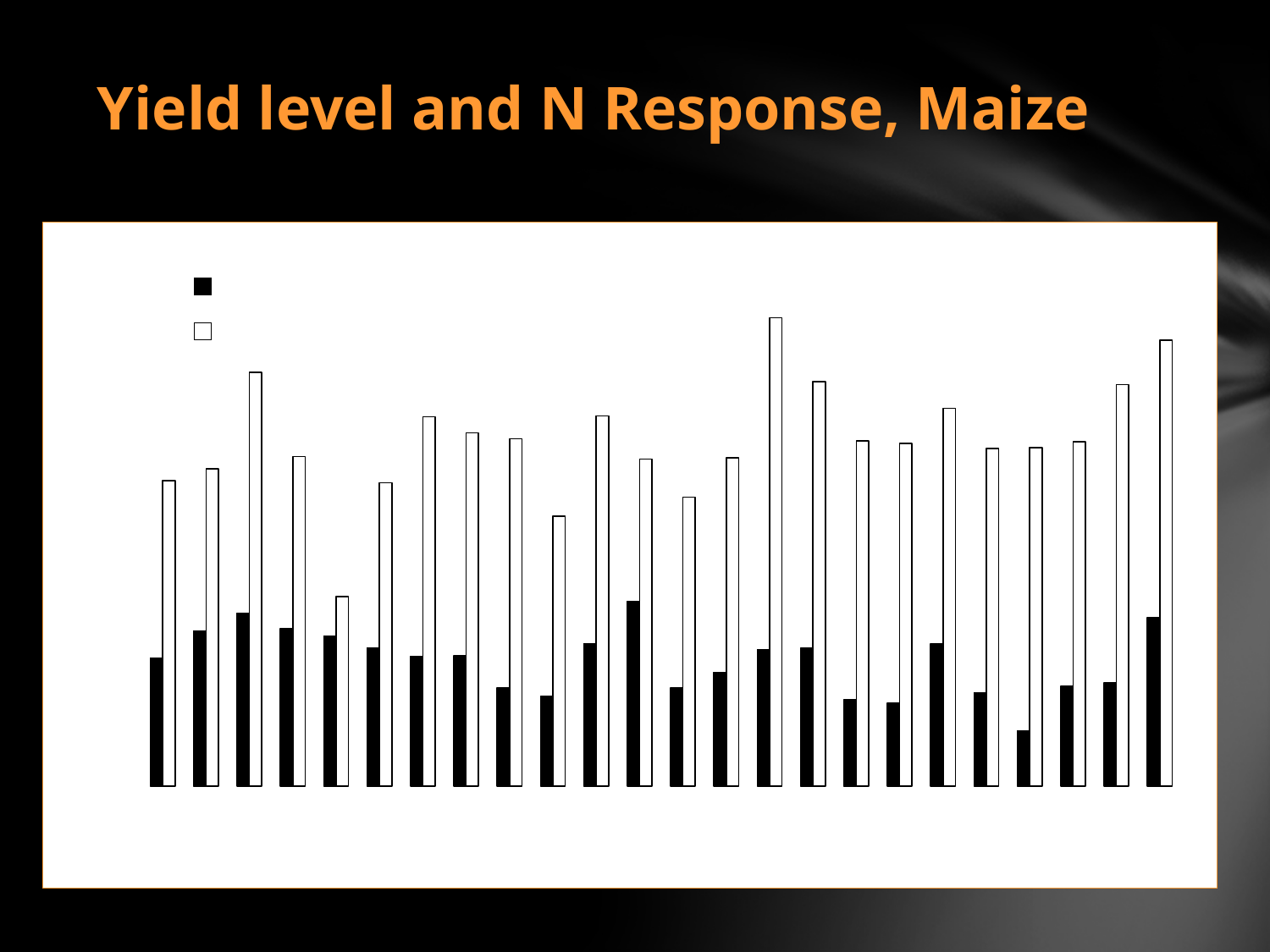
What is the title of the slide containing the chart? Yield level and N Response, Maize What kind of chart is shown on the slide? bar chart What two colours are used for the bars in the chart? black and white Counting from the left, which group has the shortest black bar? the 21st group How many groups of bars are plotted along the x axis? 24 Counting from the left, which group has the tallest white bar? the 15th group How many series does the legend list? 2 In each group, which bar is taller, the black one or the white one? the white one Counting from the left, which group has the shortest white bar? the 5th group